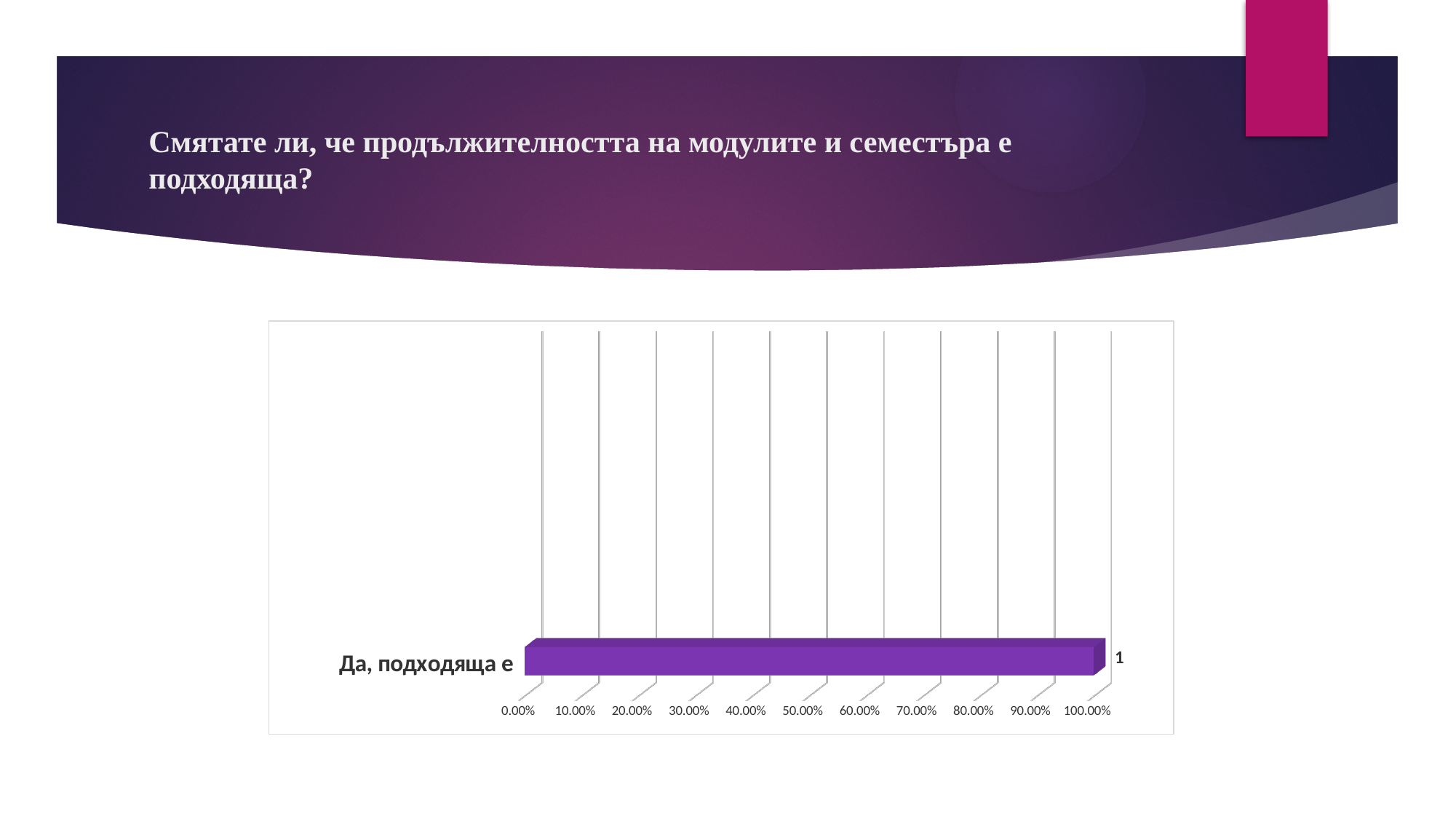
How many categories are plotted in the chart? 1 What is the label of the only category shown in the chart? Да, подходяща е Is the value for "Да, подходяща е" greater or less than 50.00%? greater What is the data label shown next to the bar for "Да, подходяща е"? 1 Is the value for "Да, подходяща е" greater or less than 90.00%? greater What kind of chart is shown on the slide? bar chart What is the highest value shown on the horizontal axis of the chart? 100.00%